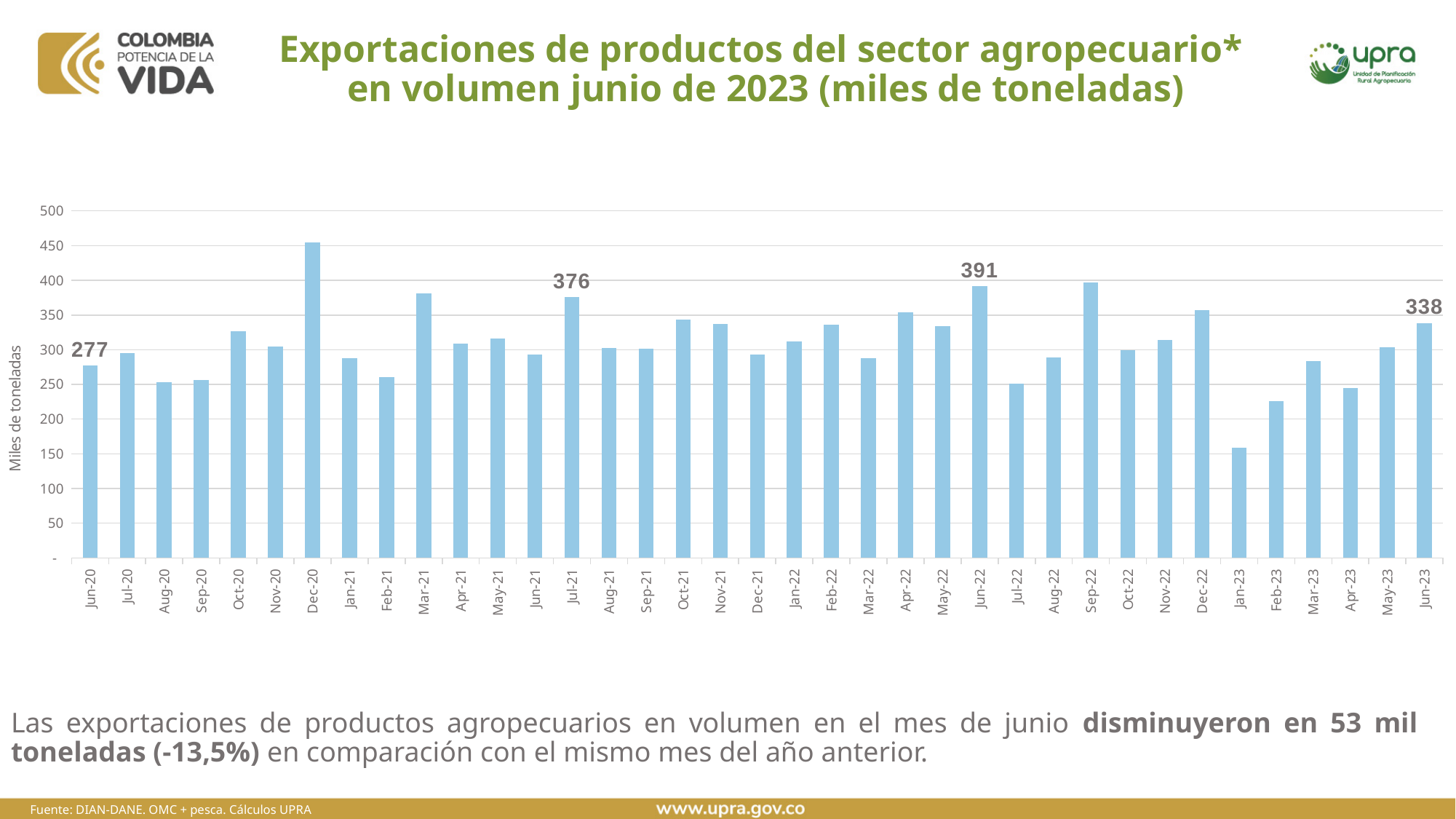
What is the value for Jun-20? 277 What is the value for Jun-22? 391 What is the value for Jul-21? 376 What kind of chart is shown on the slide? Bar chart Is the value for Dec-20 greater or less than 400? greater Which month has the highest bar? Dec-20 How many months (bars) are shown on the chart? 37 What is the value for Jun-23? 338 Which is larger, the value for Jun-22 or the value for Jun-23? Jun-22 Which month has the lowest bar? Jan-23 What is the difference between the values for Jun-22 and Jun-23? 53 Is the value for Jan-23 greater or less than 200? less